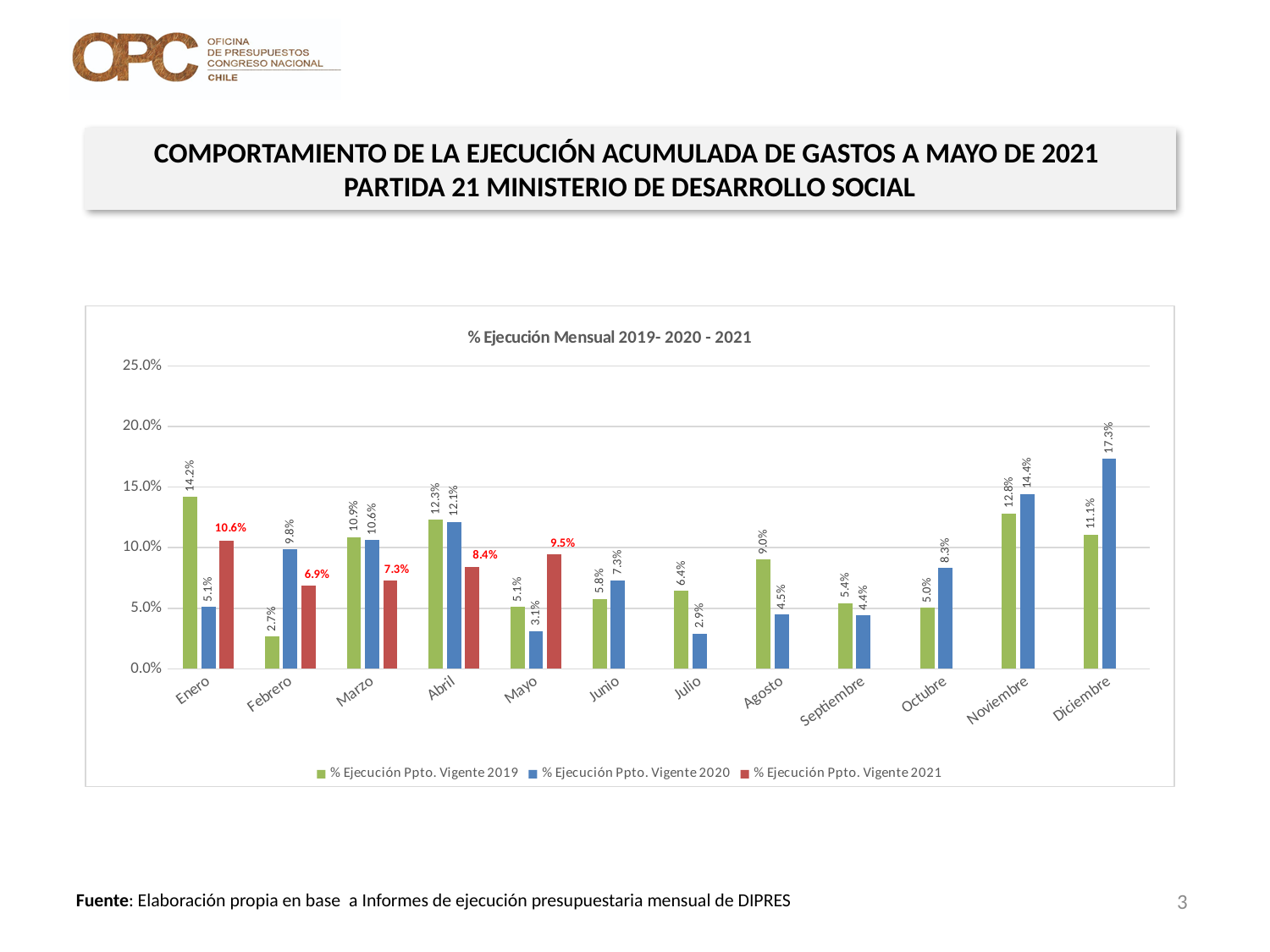
How many series does the legend list? 3 What is the value for % Ejecución Ppto. Vigente 2021 in Enero? 10.6% What is the difference between the 2019 and 2020 values in Enero? 9.1% Is the value for % Ejecución Ppto. Vigente 2020 in Noviembre greater or less than 10.0%? greater In Mayo, which series has the larger value: % Ejecución Ppto. Vigente 2021 or % Ejecución Ppto. Vigente 2019? % Ejecución Ppto. Vigente 2021 Which month has the lowest value for % Ejecución Ppto. Vigente 2019? Febrero What is the title of the chart? % Ejecución Mensual 2019- 2020 - 2021 What kind of chart is shown? Bar chart Which month has the highest value for % Ejecución Ppto. Vigente 2020? Diciembre How many months are shown on the x axis? 12 What is the value for % Ejecución Ppto. Vigente 2020 in Diciembre? 17.3% What is the value for % Ejecución Ppto. Vigente 2019 in Abril? 12.3%